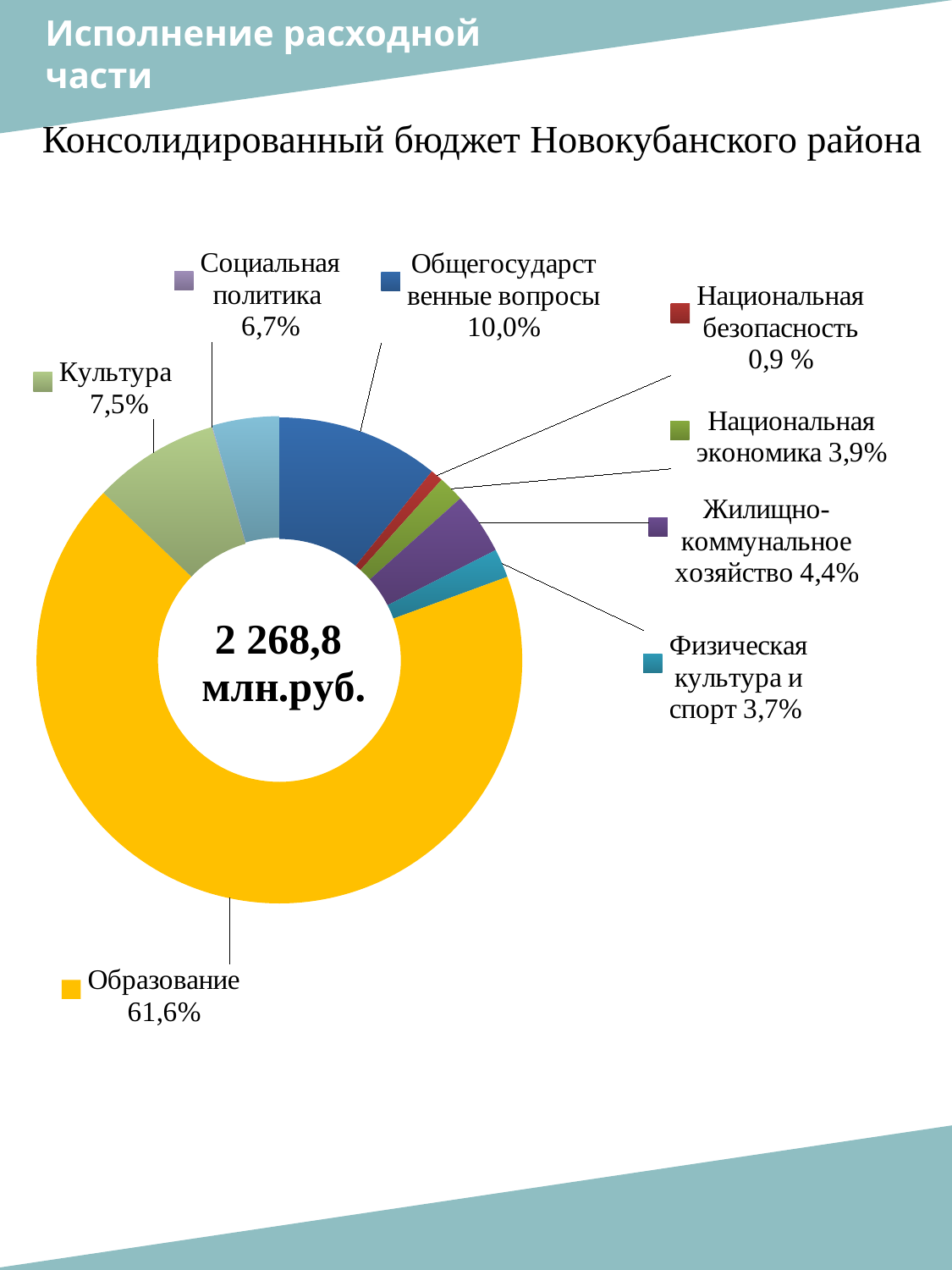
What share of the budget goes to Образование? 61,6% What share of the budget goes to Культура? 7,5% What share of the budget goes to Жилищно-коммунальное хозяйство? 4,4% How many categories are shown in the chart? 8 What total amount is shown in the centre of the chart? 2 268,8 млн.руб. What kind of chart is shown on the slide? Doughnut (pie) chart Which category has the largest share of the budget? Образование Which has a larger share: Национальная экономика or Физическая культура и спорт? Национальная экономика What is the difference in percentage points between Культура and Социальная политика? 0,8 Which category has the smallest share of the budget? Национальная безопасность What colour is the Образование segment? Yellow What share of the budget goes to Общегосударственные вопросы? 10,0%